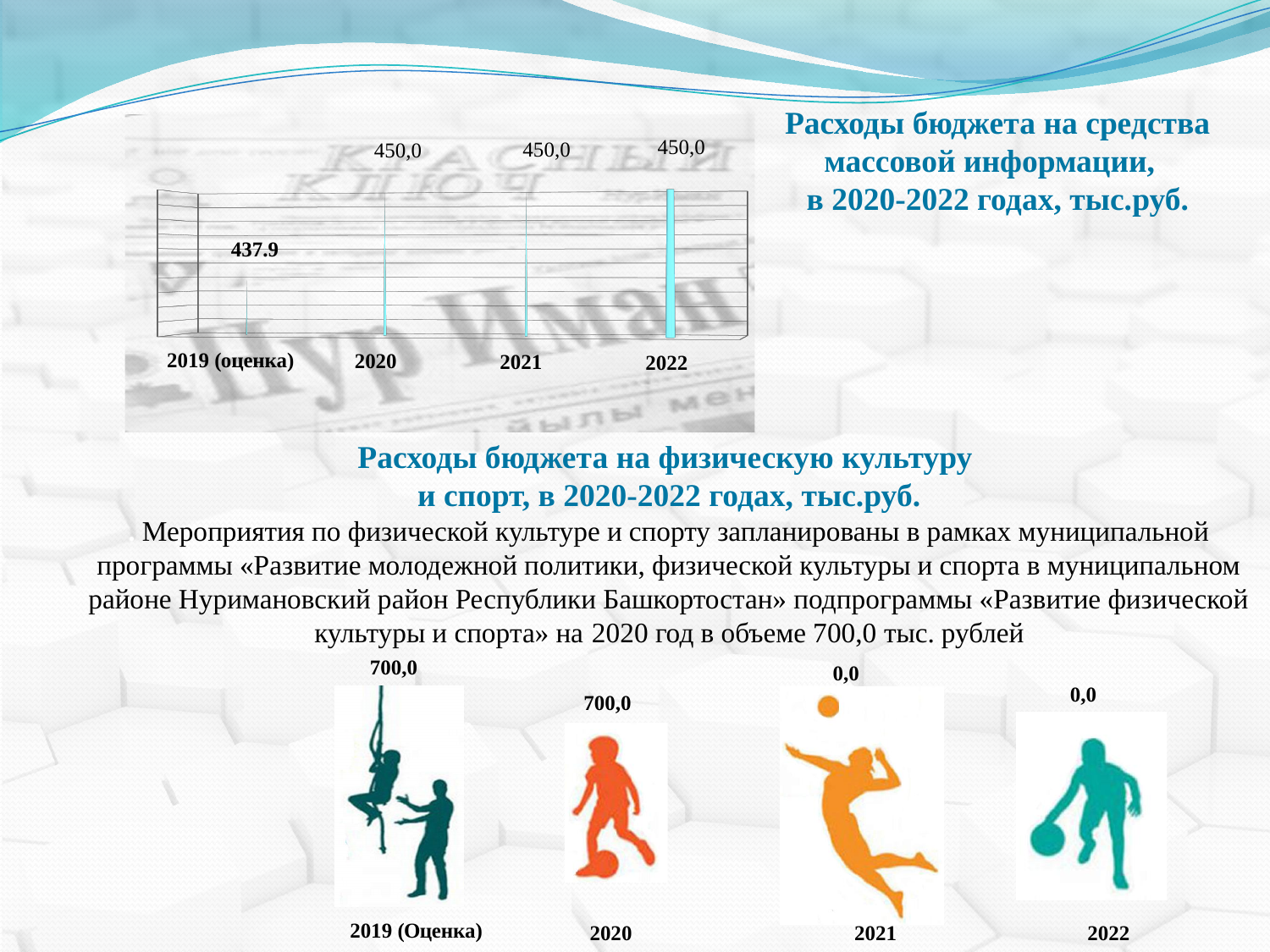
In the chart 'Расходы бюджета на средства массовой информации, в 2020-2022 годах, тыс.руб.', what is the value for 2022? 450,0 In the chart 'Расходы бюджета на средства массовой информации, в 2020-2022 годах, тыс.руб.', do the values rise, fall or stay the same from 2020 to 2022? stay the same In the chart 'Расходы бюджета на средства массовой информации, в 2020-2022 годах, тыс.руб.', which category has the lowest value? 2019 (оценка) In the chart 'Расходы бюджета на средства массовой информации, в 2020-2022 годах, тыс.руб.', what is the value for 2019 (оценка)? 437.9 In the chart 'Расходы бюджета на средства массовой информации, в 2020-2022 годах, тыс.руб.', how many categories are shown on the x axis? 4 In the chart 'Расходы бюджета на средства массовой информации, в 2020-2022 годах, тыс.руб.', what is the value for 2020? 450,0 What kind of chart is 'Расходы бюджета на средства массовой информации, в 2020-2022 годах, тыс.руб.'? bar chart In the chart 'Расходы бюджета на средства массовой информации, в 2020-2022 годах, тыс.руб.', is the value for 2020 larger or smaller than the value for 2019 (оценка)? larger